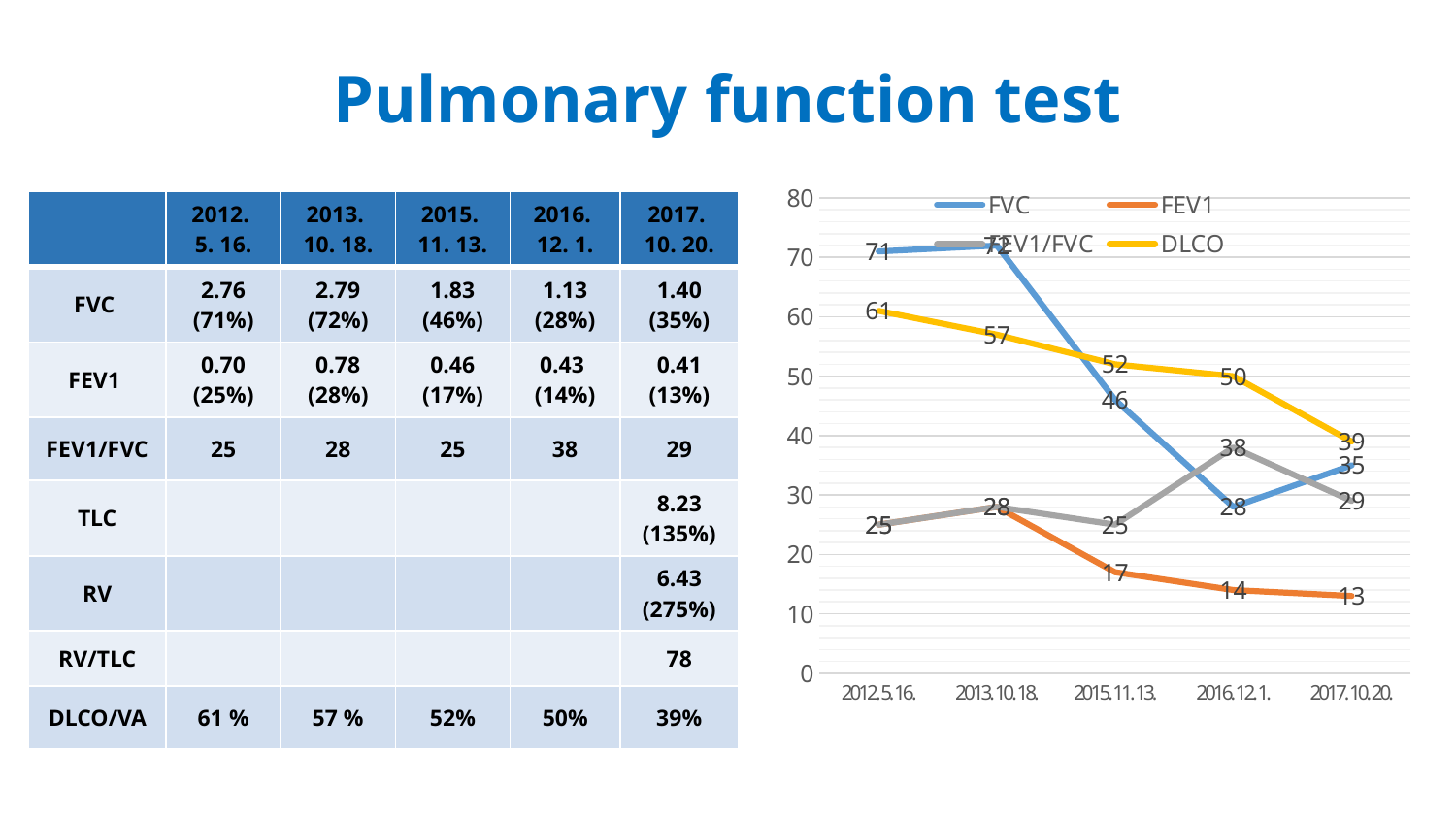
At which date does the DLCO line reach its highest value? 2012.5.16. How many dates are plotted along the x axis of the chart? 5 What type of chart is shown on the slide? line chart What is the FEV1 value plotted for 2016.12.1.? 14 What is the FVC value plotted for 2015.11.13.? 46 What is the difference between the DLCO value and the FEV1 value at 2017.10.20.? 26 Does the FEV1 line rise or fall from 2013.10.18. to 2017.10.20.? fall At which date does the FVC line reach its lowest value? 2016.12.1. What is the DLCO value plotted for 2017.10.20.? 39 How many series does the chart legend list? 4 Which is larger at 2016.12.1., the FEV1/FVC value or the FVC value? FEV1/FVC What is the FEV1/FVC value plotted for 2016.12.1.? 38